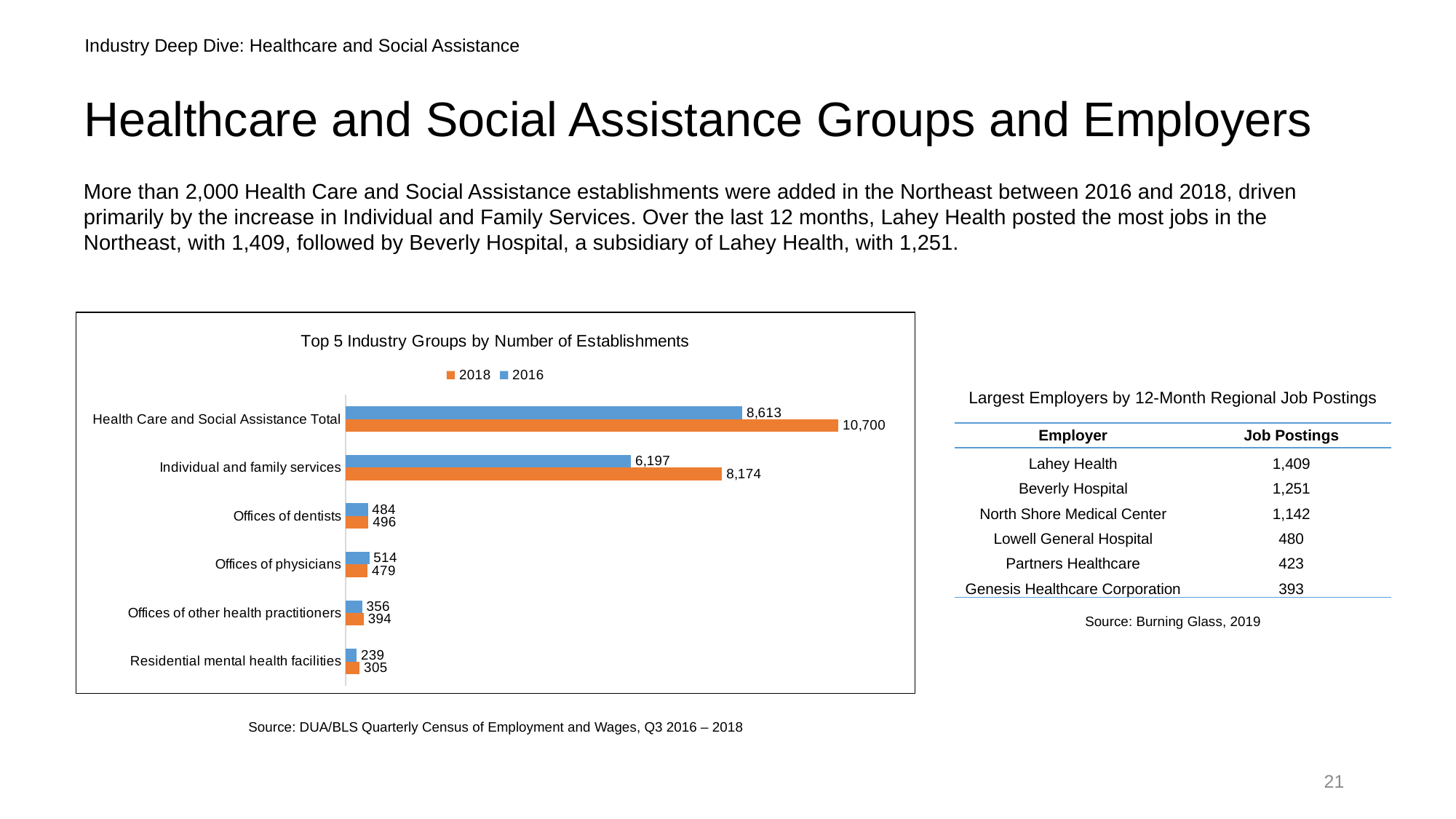
What is the 2016 value for Offices of physicians? 514 Which category has the lowest 2016 value? Residential mental health facilities Which colour represents the 2018 series in the chart? Orange What is the 2016 value for Health Care and Social Assistance Total? 8,613 What is the 2018 value for Residential mental health facilities? 305 What is the difference between the 2018 and 2016 values for Health Care and Social Assistance Total? 2,087 Which is larger for Offices of physicians, the 2016 value or the 2018 value? 2016 What type of chart is "Top 5 Industry Groups by Number of Establishments"? Bar chart Which category has the highest 2018 value? Health Care and Social Assistance Total How many categories are shown on the chart's vertical axis? 6 What is the 2018 value for Individual and family services? 8,174 How many series does the legend of the "Top 5 Industry Groups by Number of Establishments" chart list? 2